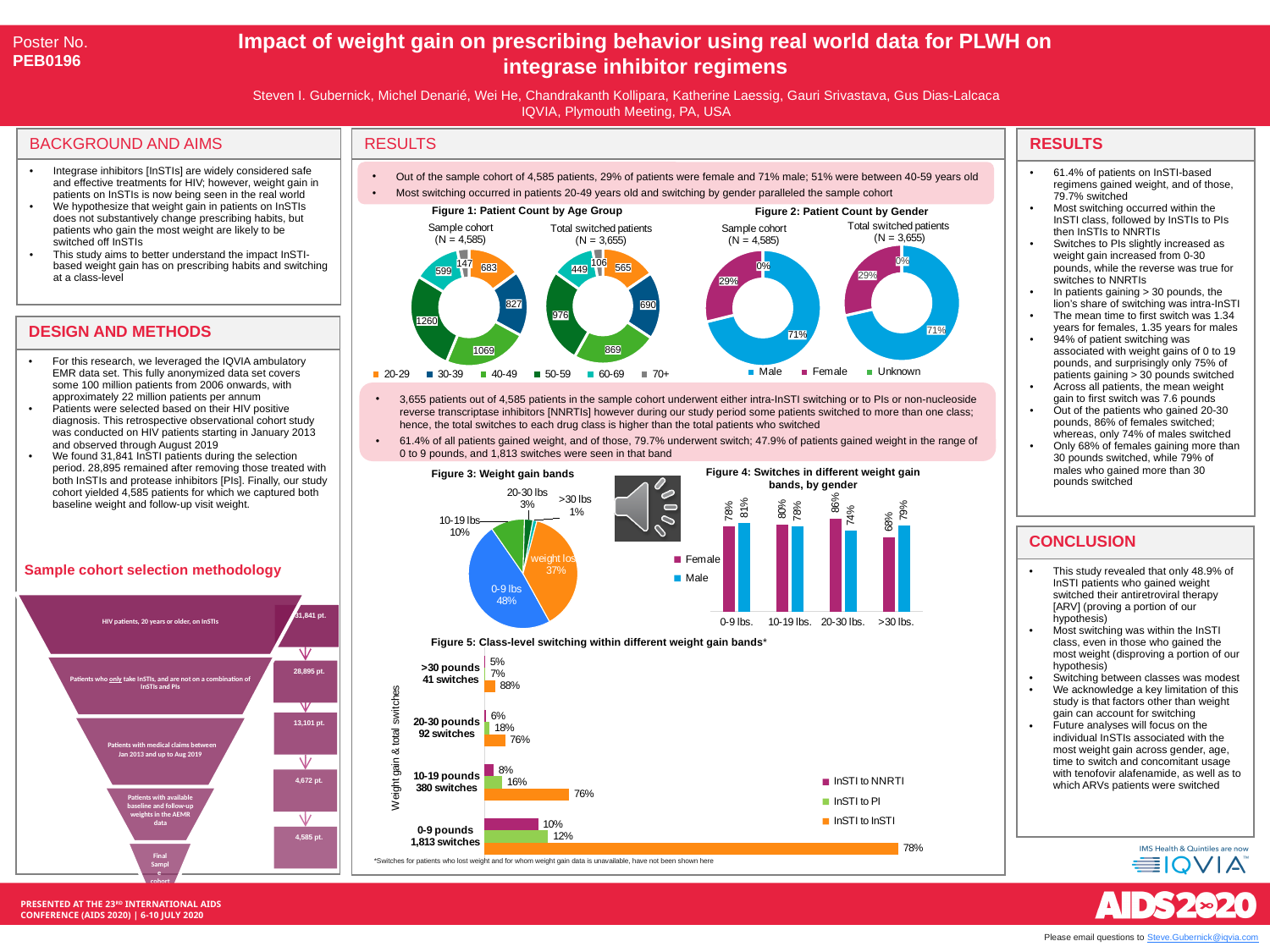
How many entries does the legend of Figure 2: Patient Count by Gender list? 3 What kind of chart is Figure 5: Class-level switching within different weight gain bands? Bar chart In Figure 4: Switches in different weight gain bands, by gender, which is larger for the >30 lbs band, Female or Male? Male In Figure 5: Class-level switching within different weight gain bands, what is the difference between the InSTI to PI and InSTI to NNRTI percentages for the 20-30 pounds band? 12% In Figure 3: Weight gain bands, which band has the smallest share? >30 lbs In Figure 3: Weight gain bands, what share of the pie is the 0-9 lbs band? 48% In Figure 4: Switches in different weight gain bands, by gender, what is the Female value for the 20-30 lbs band? 86% In Figure 5: Class-level switching within different weight gain bands, what is the InSTI to InSTI percentage for the >30 pounds band? 88% In Figure 1: Patient Count by Age Group, how many patients in the sample cohort are in the 50-59 age group? 1260 In Figure 2: Patient Count by Gender, what percentage of the sample cohort is male? 71% In Figure 1: Patient Count by Age Group, which age group has the fewest total switched patients? 70+ In Figure 1: Patient Count by Age Group, what is the difference between the sample cohort count and the total switched count for the 40-49 age group? 200